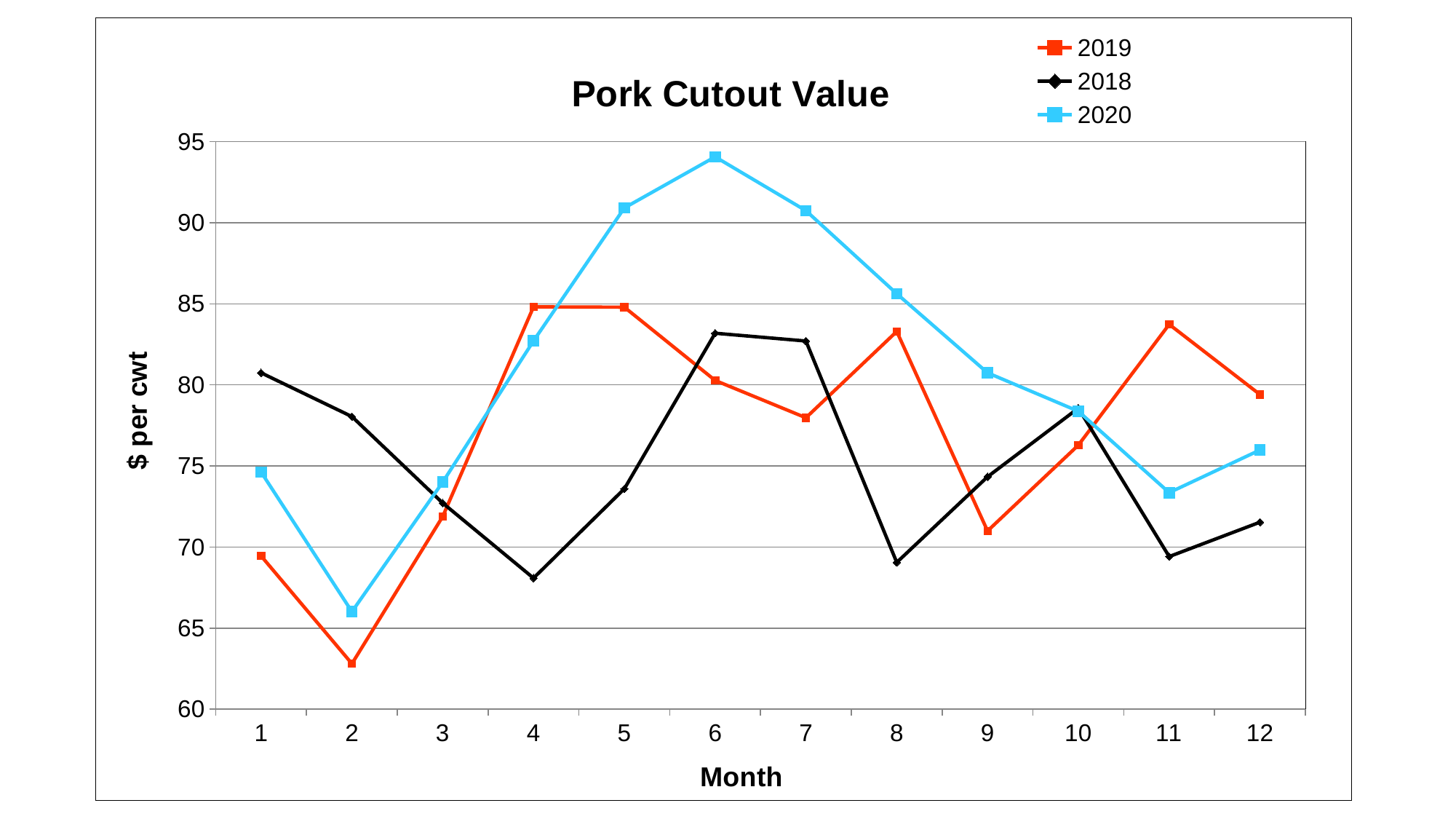
In month 1, which series has the higher value, 2018 or 2019? 2018 How many series does the legend list? 3 Is the 2020 value for month 6 greater or less than 90? greater In which month does the 2020 series reach its highest value? 6 Is the 2018 value for month 4 greater or less than 70? less How many months are plotted along the x axis? 12 Is the 2019 value for month 2 greater or less than 65? less What is the label on the y axis? $ per cwt Does the 2020 series rise or fall from month 6 to month 11? fall In month 6, which series has the higher value, 2020 or 2019? 2020 What kind of chart is shown on the slide? line chart In which month does the 2019 series reach its lowest value? 2